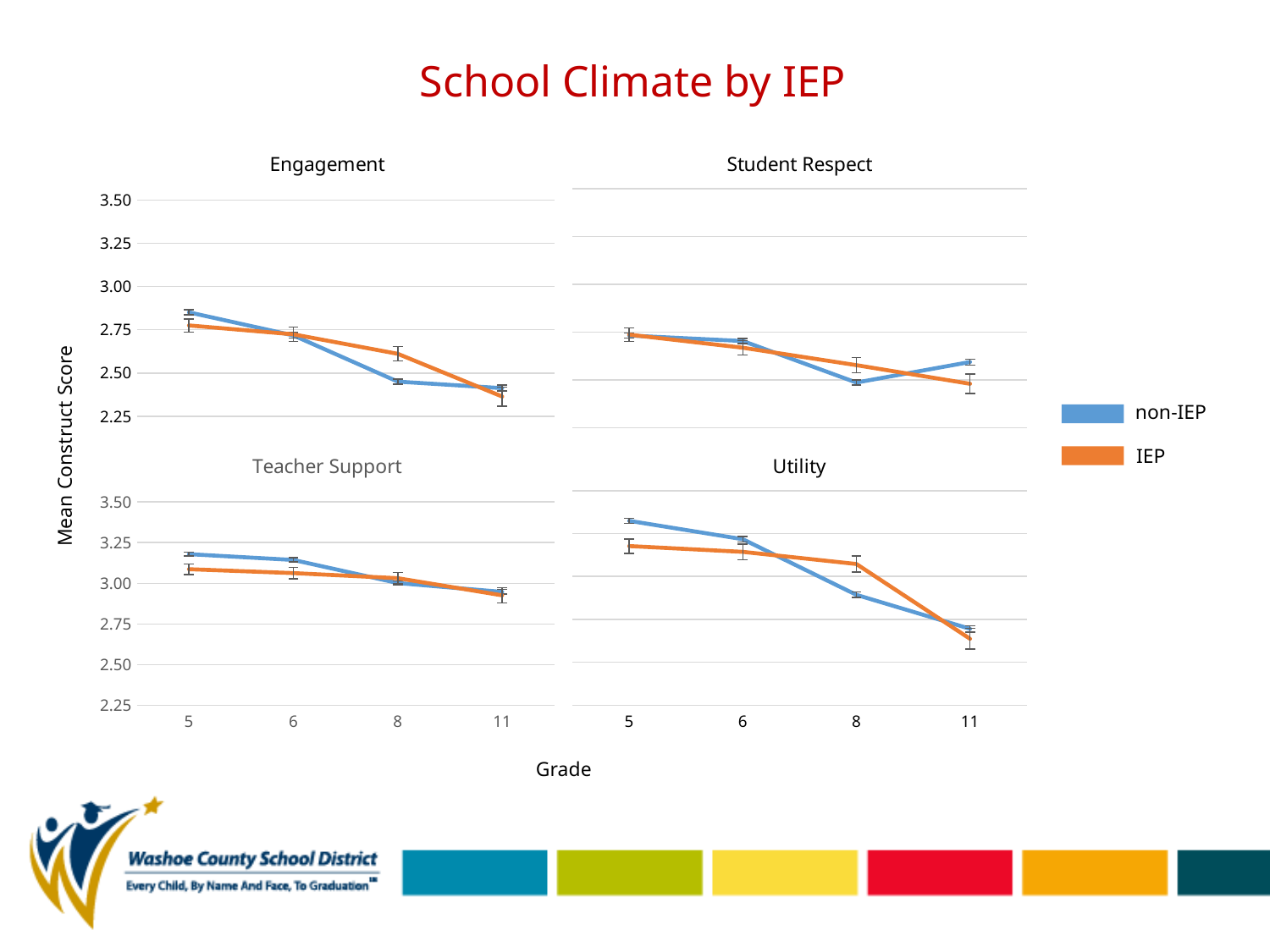
In the Teacher Support chart, is the IEP value at grade 11 greater or less than 3.00? less In the Utility chart, at which grade is the non-IEP series highest? 5 What kind of chart is used in each of the four panels on the slide? Line chart In the Utility chart, does the non-IEP series rise or fall from grade 5 to grade 11? Fall In the Engagement chart, is the non-IEP value at grade 5 greater or less than 2.75? greater How many series does the legend list? 2 What is the title of the slide's chart? School Climate by IEP In the Utility chart, is the IEP value at grade 11 greater or less than 2.75? less In the Engagement chart, which series has the higher value at grade 8, non-IEP or IEP? IEP How many grade levels are shown on the x axis of the Utility chart? 4 In the Student Respect chart, which series has the higher value at grade 11, non-IEP or IEP? non-IEP